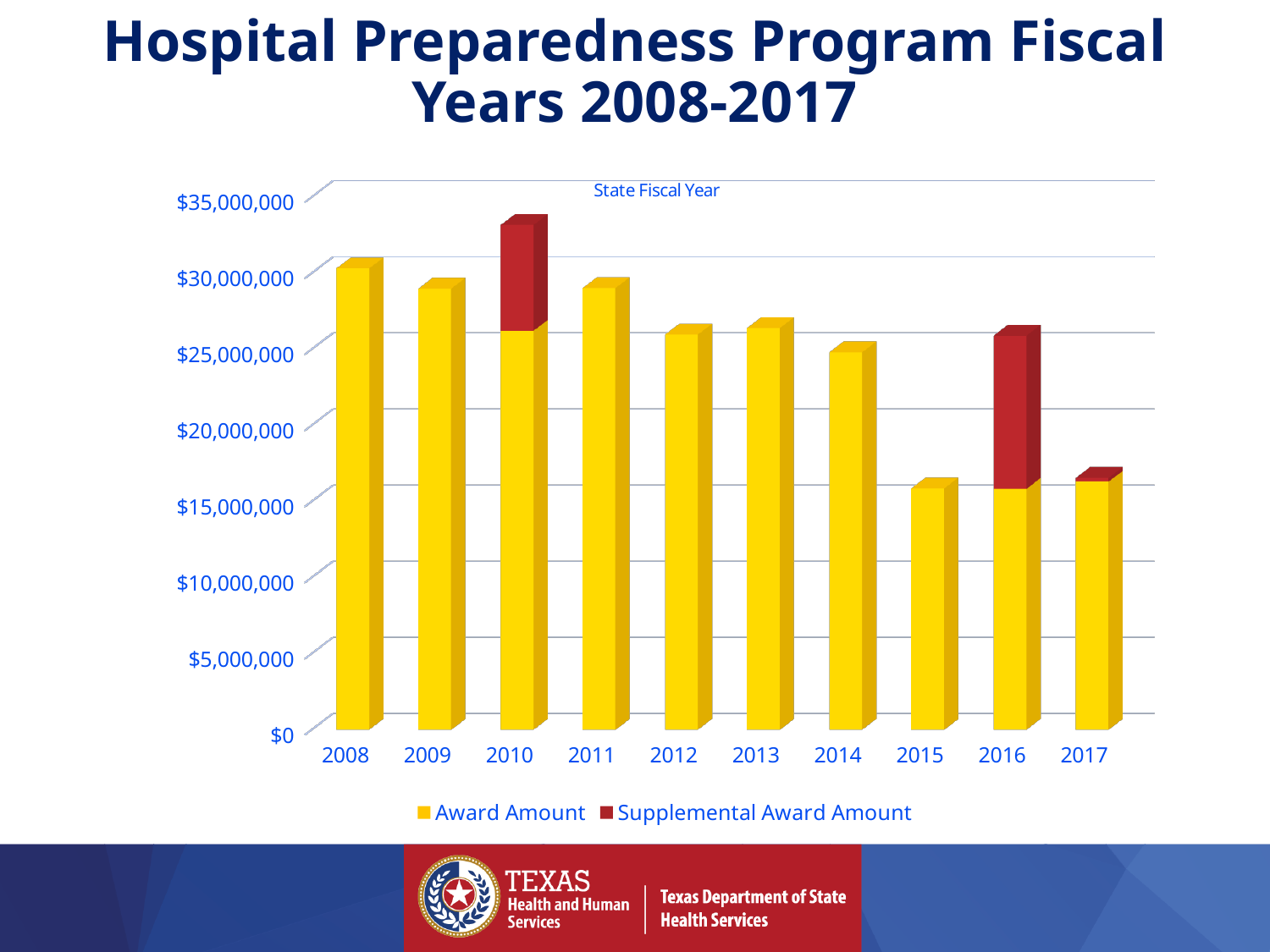
Which is larger, the Award Amount for 2008 or the Award Amount for 2015? 2008 How many series does the chart's legend list? 2 What kind of chart is shown on the slide? bar chart Is the total bar for 2010 greater or less than $30,000,000? greater Which fiscal year has the highest Award Amount? 2008 Is the Award Amount for 2015 greater or less than $20,000,000? less Which year has the larger Supplemental Award Amount, 2016 or 2017? 2016 Which colour represents the Supplemental Award Amount series in the legend? red Is the Award Amount for 2008 greater or less than $25,000,000? greater Which fiscal year has the tallest total bar (Award Amount plus Supplemental Award Amount)? 2010 Overall, do the Award Amounts rise or fall from 2008 to 2017? fall How many fiscal years are shown on the x axis of the chart? 10